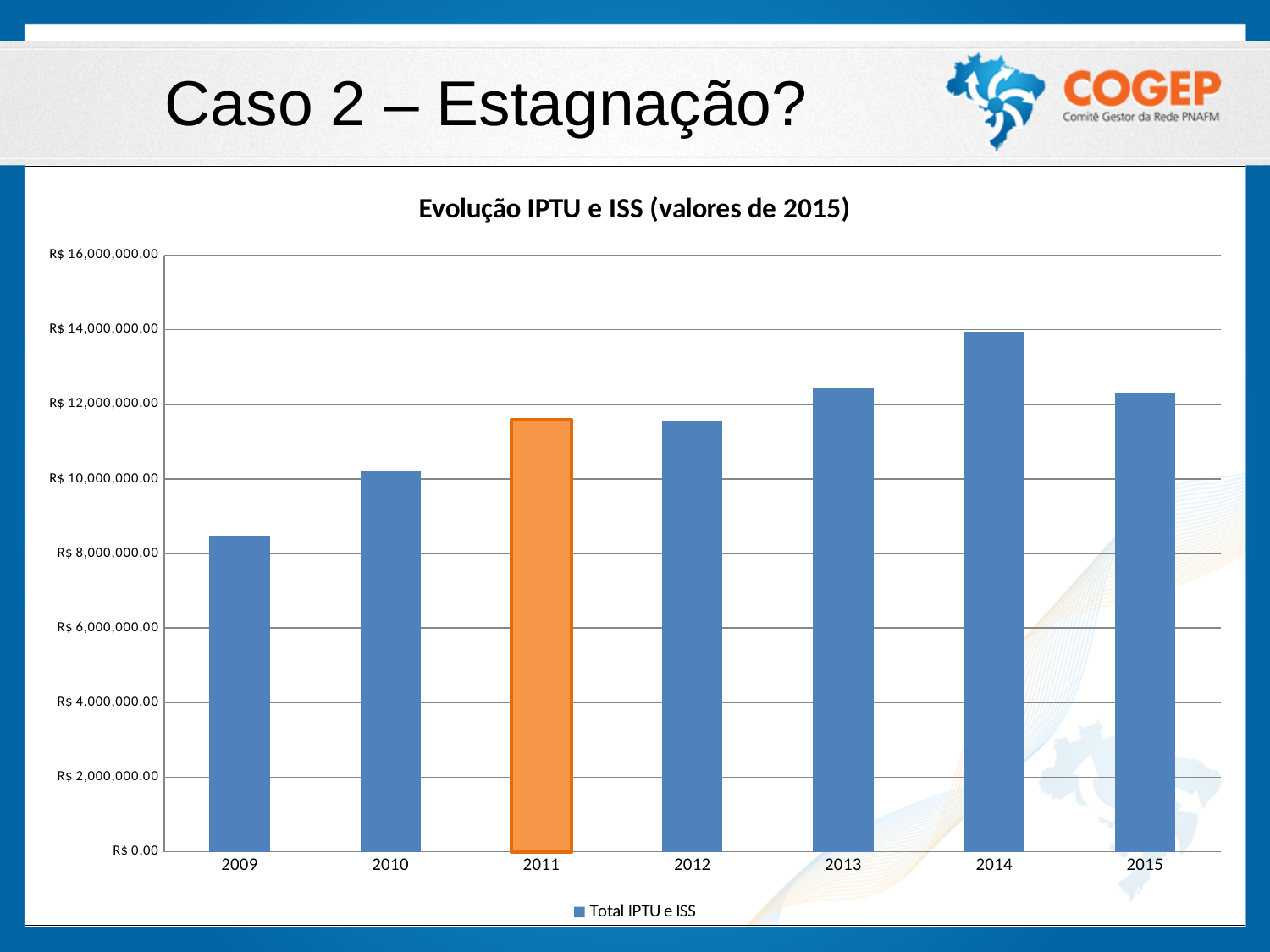
What is the title of the chart? Evolução IPTU e ISS (valores de 2015) How many years are shown on the x axis of the chart? 7 What kind of chart is shown on the slide? bar chart Is the value for 2009 greater or less than R$ 10,000,000.00? less Which year has the lowest value for Total IPTU e ISS? 2009 Which year's bar is highlighted in orange? 2011 Is the value for 2014 greater or less than R$ 12,000,000.00? greater Which year has the highest value for Total IPTU e ISS? 2014 How many series does the legend list? 1 Which is larger, the value for 2013 or the value for 2010? 2013 Do the values rise or fall from 2009 to 2011? rise Is the value for 2012 greater or less than R$ 12,000,000.00? less